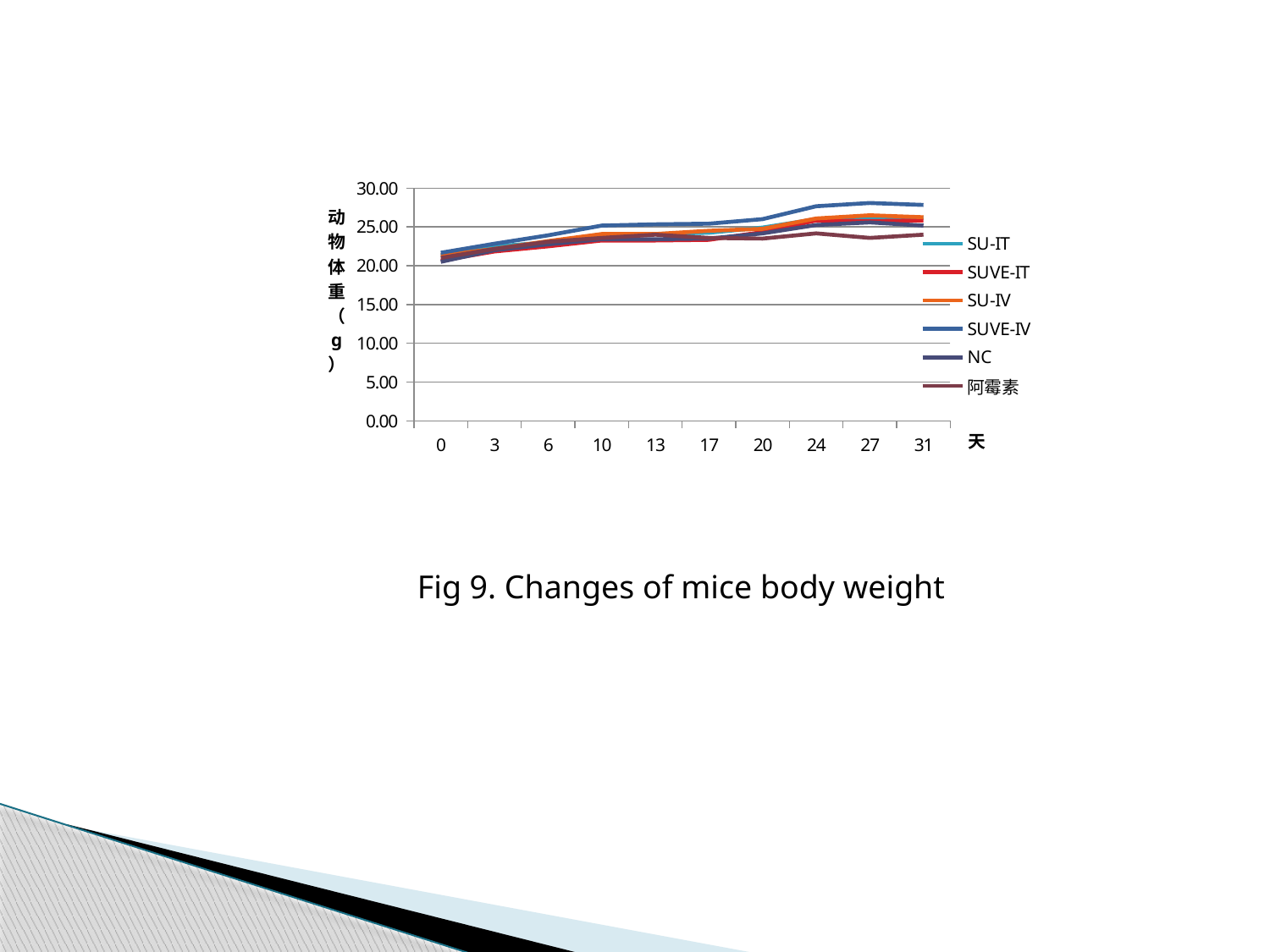
Is the value for SUVE-IV at day 0 greater or less than 20.00? greater At day 31, which is larger: the value for SUVE-IV or the value for 阿霉素? SUVE-IV How many series does the legend list? 6 Which series has the lowest value at day 27? 阿霉素 What kind of chart is shown on the slide? line chart What is the label of the x axis? 天 Does the SUVE-IV series generally rise or fall from day 0 to day 31? rise How many time points are plotted along the x axis? 10 What is the caption given below the chart? Fig 9. Changes of mice body weight Is the value for 阿霉素 at day 27 greater or less than 25.00? less Which series has the highest value at day 31? SUVE-IV Is the value for SUVE-IV at day 31 greater or less than 25.00? greater